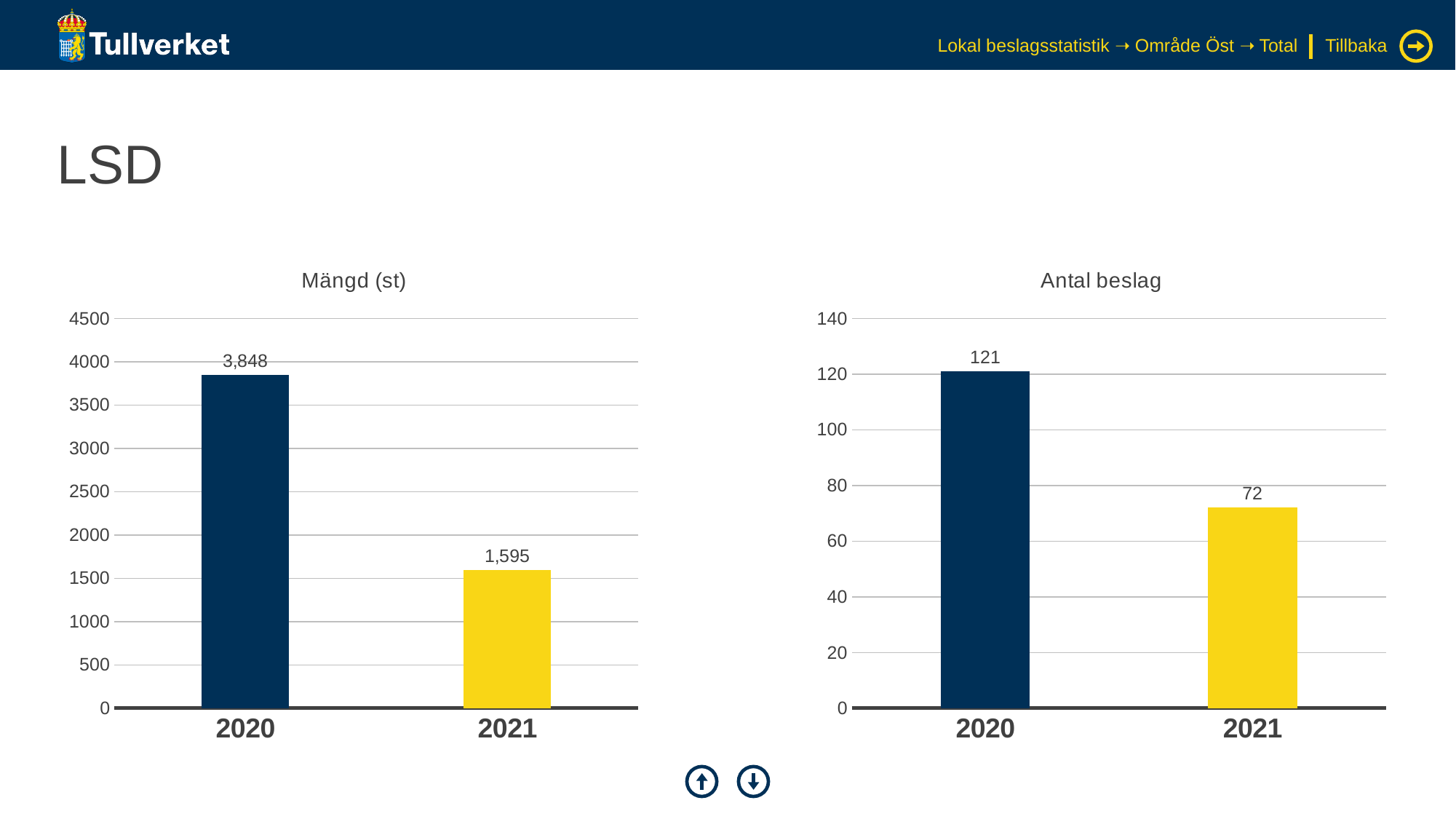
How many years are shown in the 'Mängd (st)' chart? 2 In the 'Mängd (st)' chart, which year has the highest value? 2020 In the 'Antal beslag' chart, what is the value for 2020? 121 In the 'Antal beslag' chart, is the value for 2021 greater or less than 80? less In the 'Antal beslag' chart, what is the difference between the 2020 and 2021 values? 49 What kind of chart is the 'Antal beslag' chart? bar chart In the 'Mängd (st)' chart, what is the value for 2021? 1,595 In the 'Mängd (st)' chart, what is the difference between the 2020 and 2021 values? 2,253 In the 'Mängd (st)' chart, what is the value for 2020? 3,848 In the 'Antal beslag' chart, which year has the lowest value? 2021 In the 'Mängd (st)' chart, do the values rise or fall from 2020 to 2021? fall In the 'Antal beslag' chart, what is the value for 2021? 72